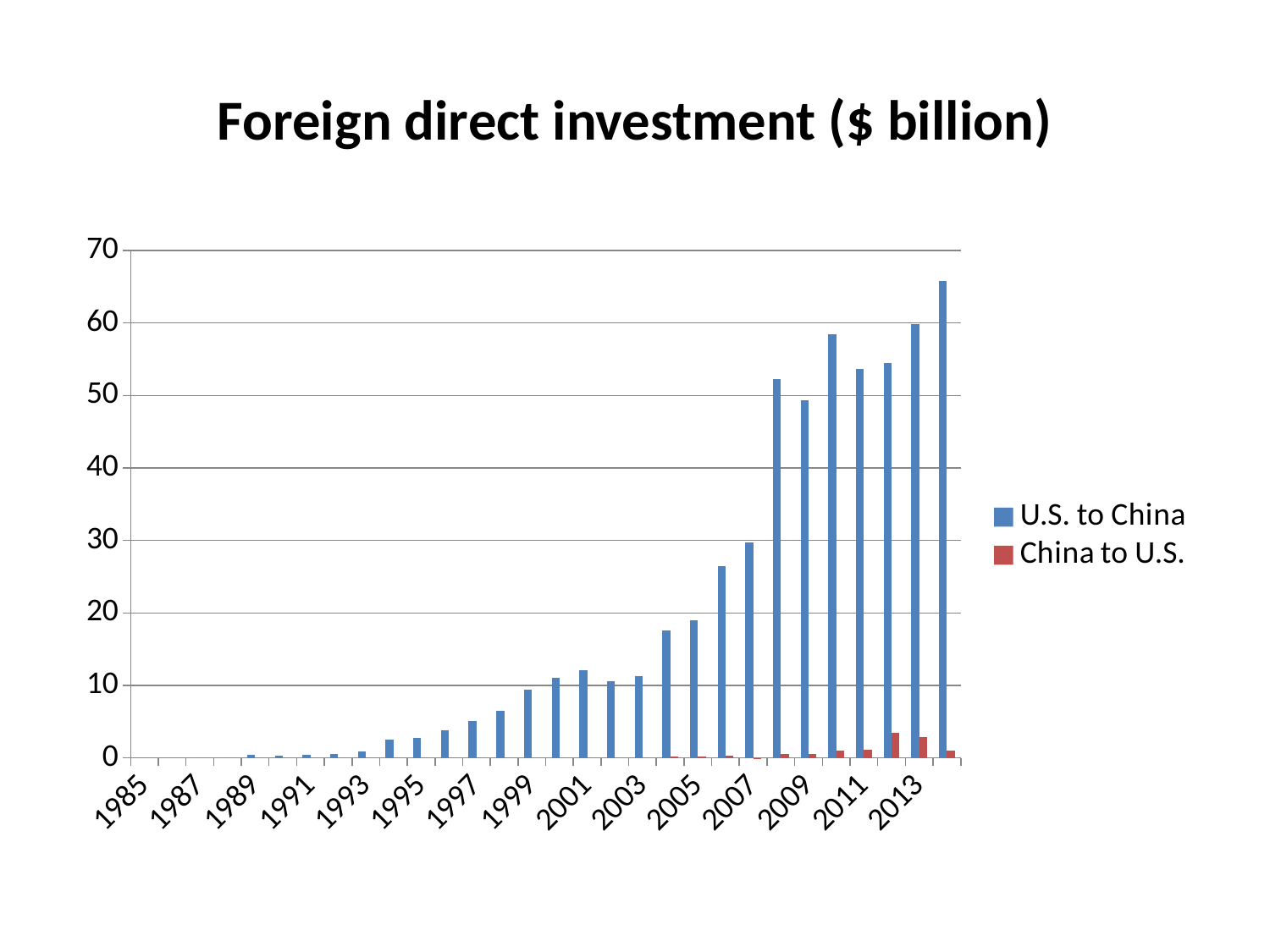
How many series does the legend list? 2 In 2013, which series has the larger value, U.S. to China or China to U.S.? U.S. to China Is the U.S. to China value for 2011 greater or less than 50? greater Which is larger, the U.S. to China value for 2009 or for 2007? 2009 Which series is drawn in red? China to U.S. Is the China to U.S. value for 2013 greater or less than 10? less What kind of chart is shown on the slide? bar chart Which is larger, the U.S. to China value for 2011 or for 2009? 2011 What is the title of the chart? Foreign direct investment ($ billion) Does the U.S. to China series generally rise or fall from 1985 to the last year shown? rise Is the U.S. to China value for 1995 greater or less than 10? less